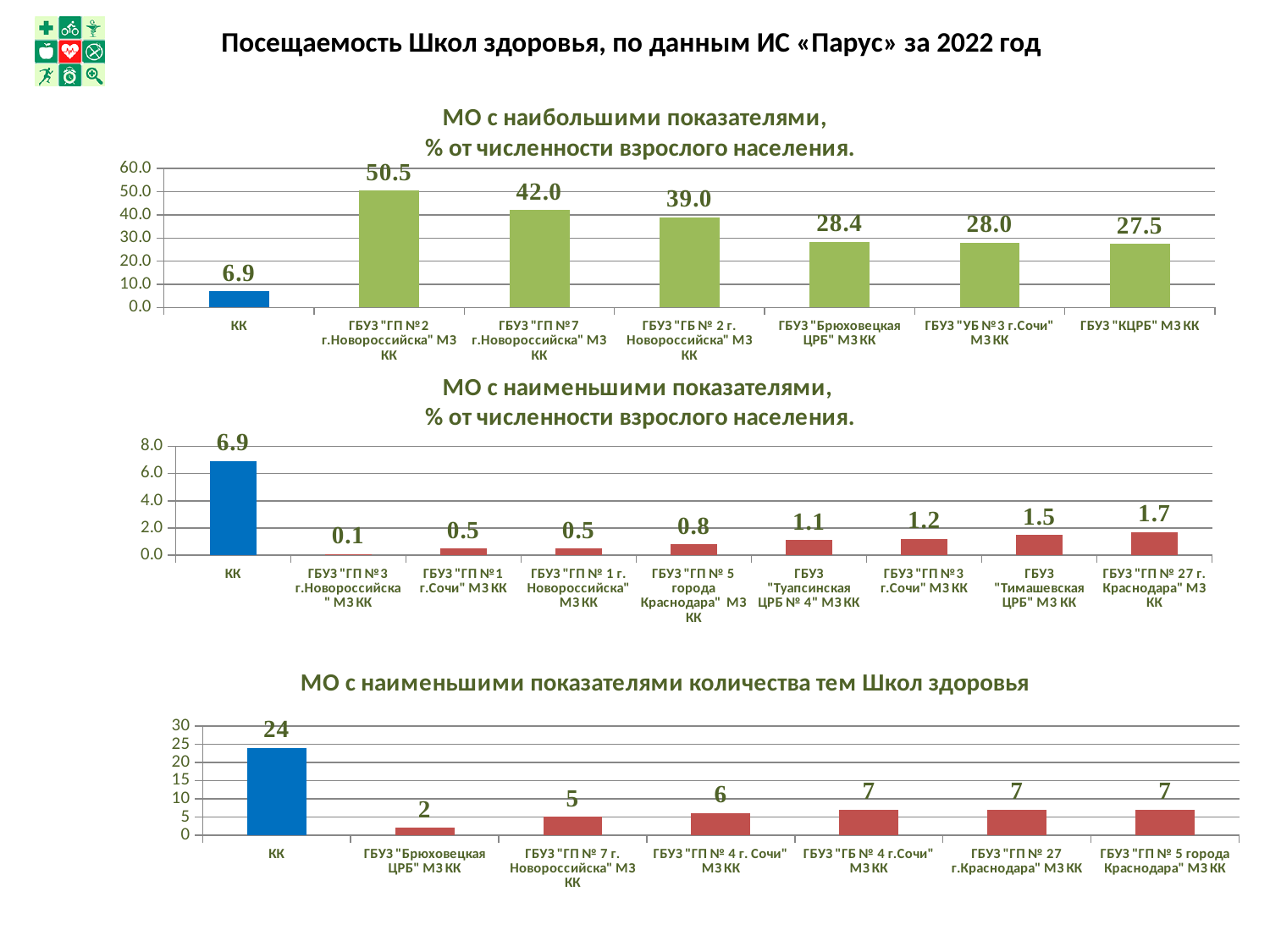
In the middle chart (МО с наименьшими показателями, % от численности взрослого населения), which category has the highest value? КК In the bottom chart (МО с наименьшими показателями количества тем Школ здоровья), is the value for КК greater or less than 20? greater In the bottom chart (МО с наименьшими показателями количества тем Школ здоровья), what is the difference between КК and ГБУЗ "ГП № 4 г. Сочи" МЗ КК? 18 How many categories are shown in the middle chart (МО с наименьшими показателями, % от численности взрослого населения)? 9 In the middle chart (МО с наименьшими показателями, % от численности взрослого населения), which is larger: ГБУЗ "Тимашевская ЦРБ" МЗ КК or ГБУЗ "ГП № 27 г. Краснодара" МЗ КК? ГБУЗ "ГП № 27 г. Краснодара" МЗ КК What type of chart is the bottom chart (МО с наименьшими показателями количества тем Школ здоровья)? Bar chart In the top chart (МО с наибольшими показателями), what is the difference between ГБУЗ "ГП №7 г.Новороссийска" МЗ КК and ГБУЗ "ГБ № 2 г. Новороссийска" МЗ КК? 3.0 In the bottom chart (МО с наименьшими показателями количества тем Школ здоровья), what is the value for ГБУЗ "Брюховецкая ЦРБ" МЗ КК? 2 In the middle chart (МО с наименьшими показателями, % от численности взрослого населения), what is the value for ГБУЗ "ГП №3 г.Новороссийска" МЗ КК? 0.1 In the top chart (МО с наибольшими показателями), which category has the lowest value? КК In the top chart (МО с наибольшими показателями), what is the value for ГБУЗ "ГП №2 г.Новороссийска" МЗ КК? 50.5 How many categories are shown in the top chart (МО с наибольшими показателями)? 7